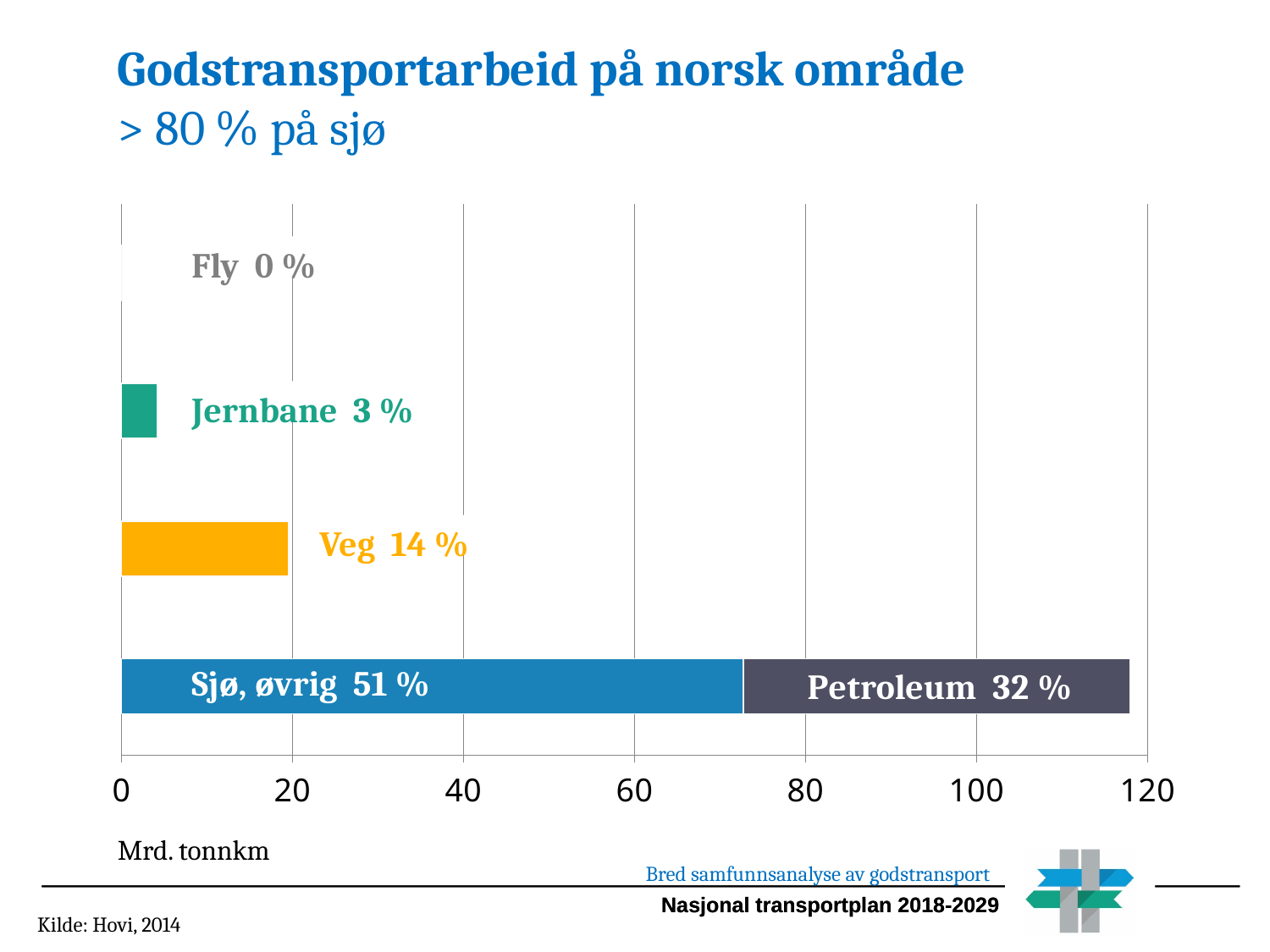
What percentage share is shown for Fly? 0 % What is the combined percentage share of the stacked sea bar (Sjø, øvrig plus Petroleum)? 83 % Which has a larger share, Veg or Jernbane? Veg What is the difference in percentage points between Sjø, øvrig and Petroleum? 19 percentage points What percentage share is shown for Veg? 14 % What unit is given for the horizontal axis? Mrd. tonnkm Which labelled segment has the largest percentage share? Sjø, øvrig What percentage share is shown for Jernbane? 3 % Which transport mode has the smallest percentage share? Fly What percentage share is shown for Petroleum? 32 % What kind of chart is shown on the slide? Bar chart Is the value for Sjø, øvrig in Mrd. tonnkm greater or less than 60? greater